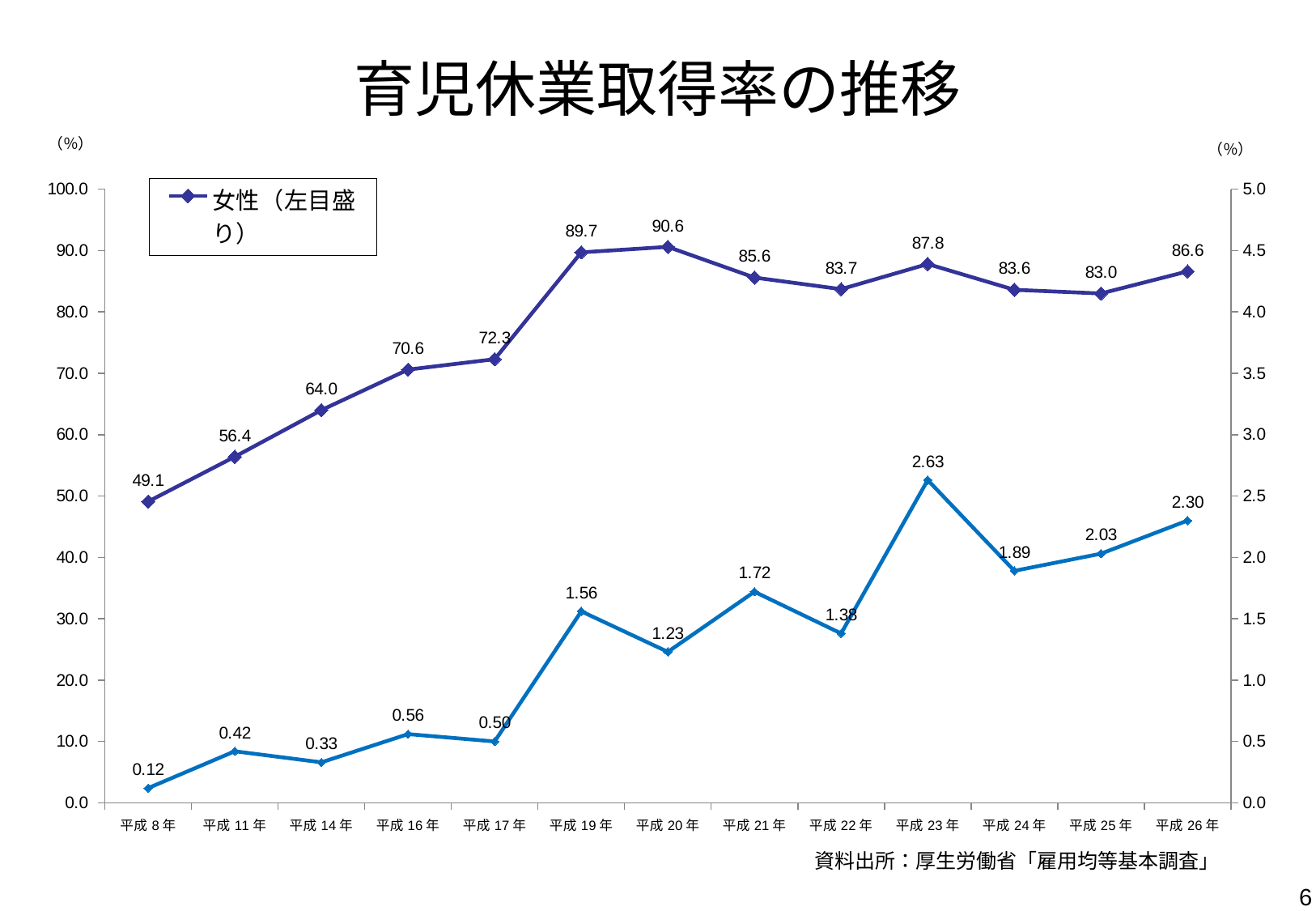
What kind of chart is shown on the slide? line chart In which year does 女性（左目盛り） reach its highest value? 平成 20 年 What is the title of the chart? 育児休業取得率の推移 Which is larger for the lower light-blue line (right axis): the value in 平成 24 年 or in 平成 25 年? 平成 25 年 What is the value of the lower light-blue line (right axis) in 平成 23 年? 2.63 What is the value of 女性（左目盛り） in 平成 20 年? 90.6 Does the 女性（左目盛り） line rise or fall from 平成 8 年 to 平成 20 年? rise How many years are plotted along the x axis? 13 What is the value of 女性（左目盛り） in 平成 8 年? 49.1 How many series does the legend list? 1 What is the difference between the 女性（左目盛り） values in 平成 26 年 and 平成 25 年? 3.6 In which year is the lower light-blue line (right axis) at its lowest value? 平成 8 年